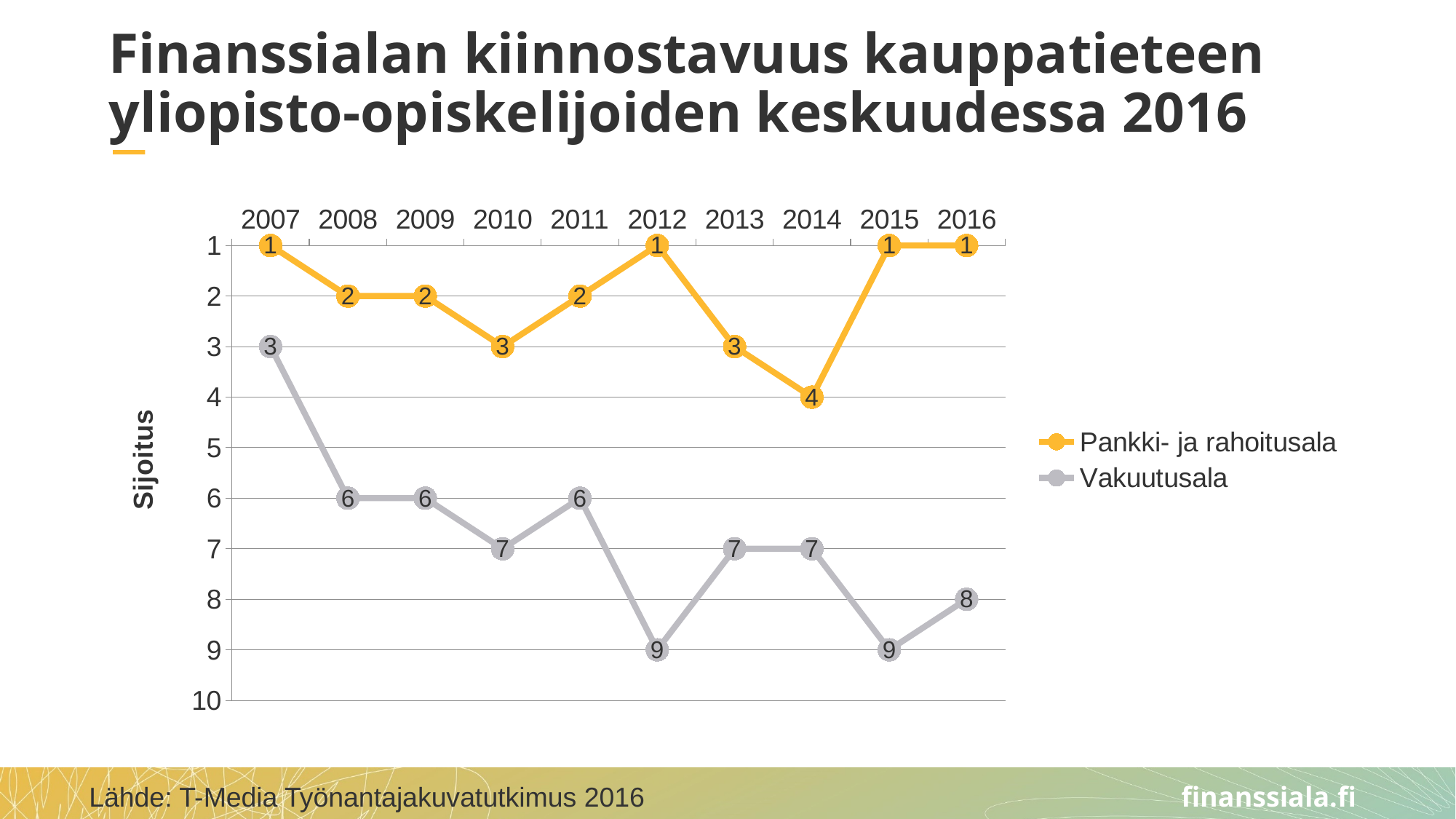
What type of chart is shown on the slide? line chart What is the value for Vakuutusala in 2007? 3 What is the difference between the Vakuutusala value and the Pankki- ja rahoitusala value in 2012? 8 In which year does Pankki- ja rahoitusala reach its largest numeric value? 2014 What is the value for Vakuutusala in 2016? 8 What is the label of the y axis? Sijoitus How many years are plotted along the x axis? 10 How many series does the legend list? 2 What is the value for Pankki- ja rahoitusala in 2010? 3 What is the difference between the Vakuutusala values in 2015 and 2016? 1 What is the value for Pankki- ja rahoitusala in 2014? 4 Which series has the larger numeric value in 2013, Pankki- ja rahoitusala or Vakuutusala? Vakuutusala